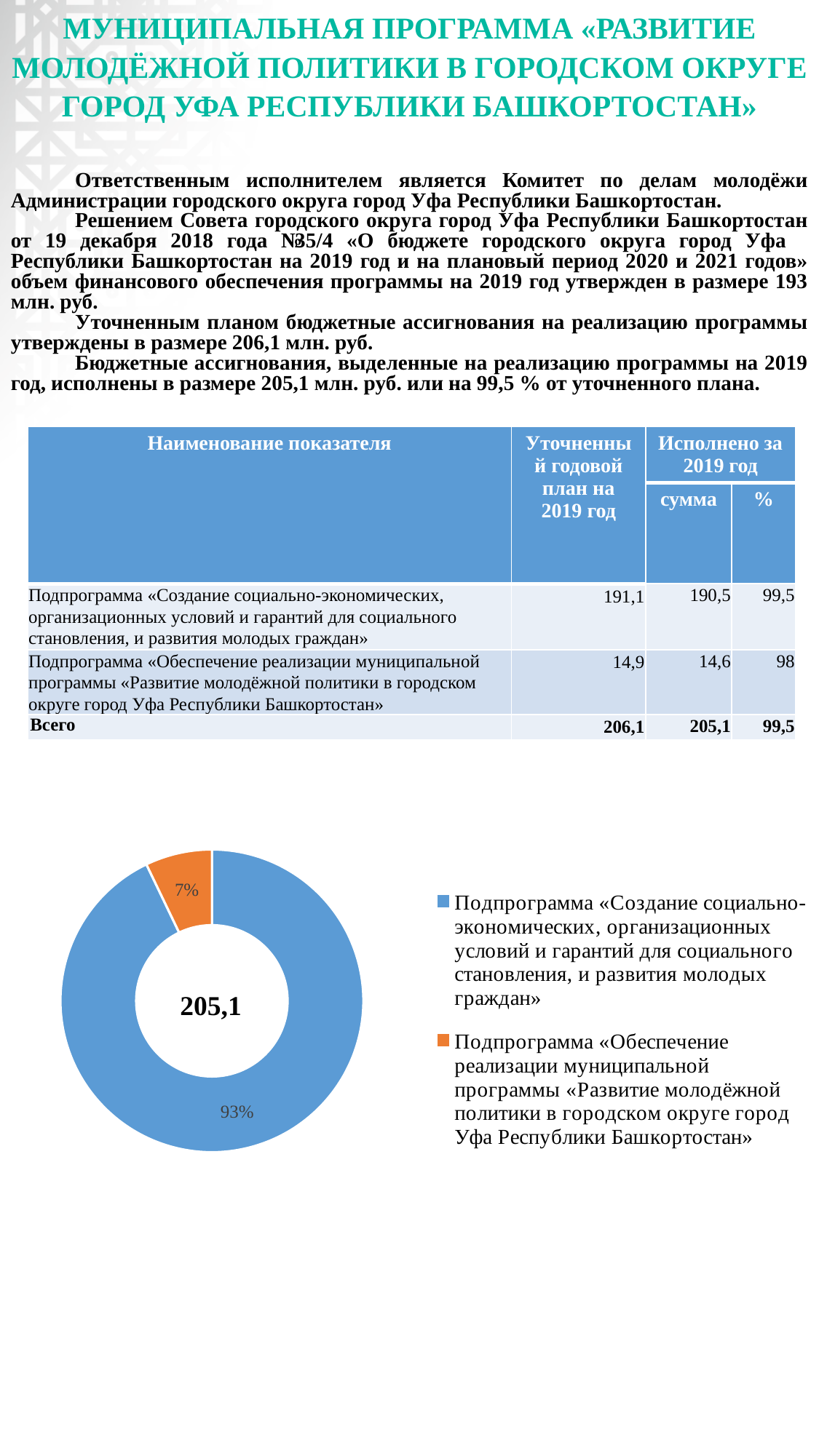
What kind of chart is shown on the slide? Doughnut chart Which slice of the doughnut chart is the smallest? Подпрограмма «Обеспечение реализации муниципальной программы «Развитие молодёжной политики в городском округе город Уфа Республики Башкортостан»» What share of the doughnut chart does the subprogram «Создание социально-экономических, организационных условий и гарантий для социального становления, и развития молодых граждан» take? 93% What colour is the slice for the subprogram «Обеспечение реализации муниципальной программы...» in the doughnut chart? Orange In the doughnut chart, which is larger: the blue slice or the orange slice? The blue slice How many slices does the doughnut chart have? 2 What value is printed in the centre of the doughnut chart? 205,1 What share of the doughnut chart does the subprogram «Обеспечение реализации муниципальной программы «Развитие молодёжной политики в городском округе город Уфа Республики Башкортостан»» take? 7% Which slice of the doughnut chart is the largest? Подпрограмма «Создание социально-экономических, организационных условий и гарантий для социального становления, и развития молодых граждан» How many entries does the legend of the doughnut chart list? 2 By how many percentage points does the 93% slice exceed the 7% slice in the doughnut chart? 86 percentage points